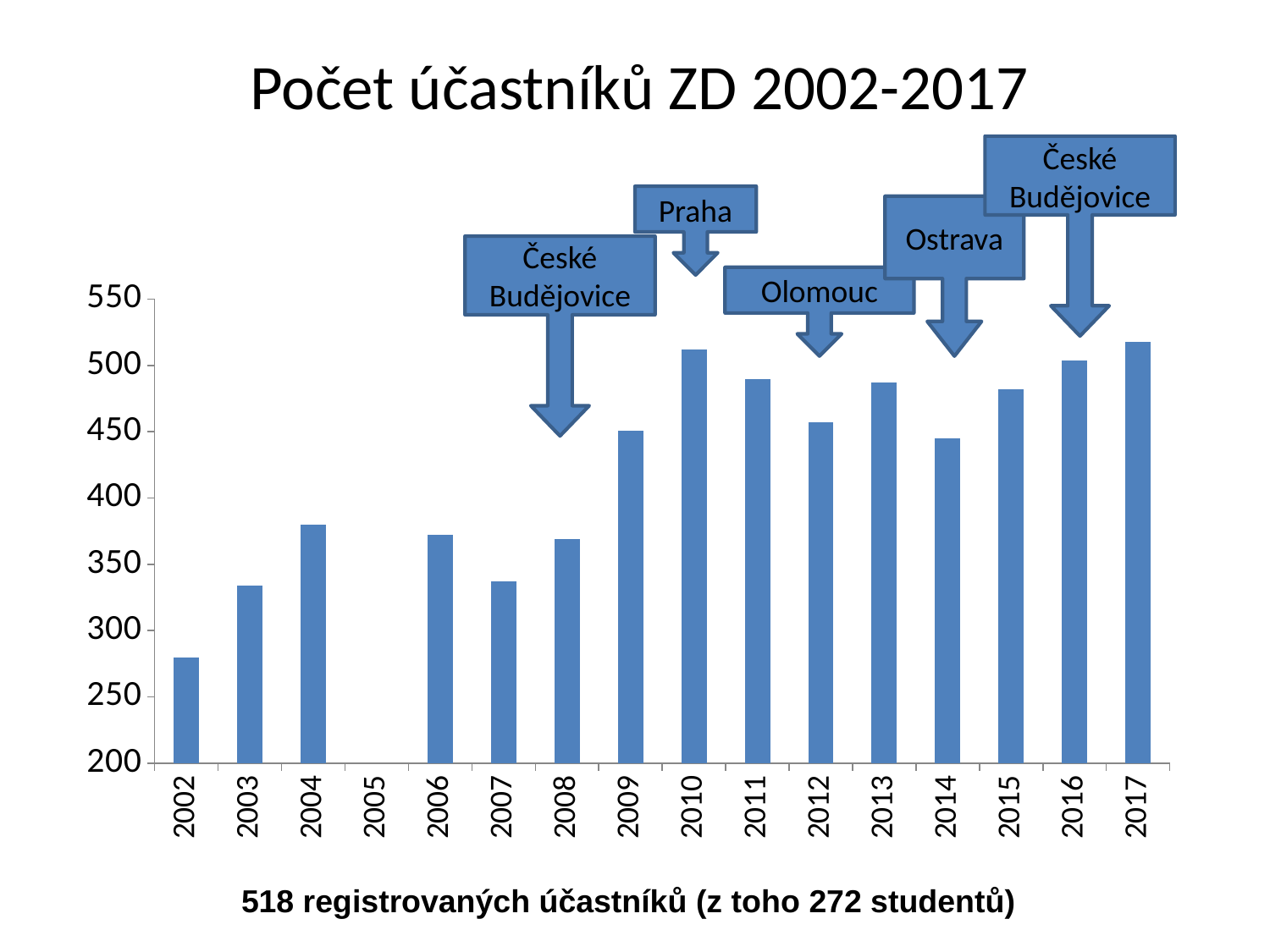
Which year has the higher value, 2003 or 2004? 2004 Is the value for 2004 greater or less than 350? greater Which year on the x axis has no bar plotted? 2005 What is the title of the chart? Počet účastníků ZD 2002-2017 What kind of chart is shown on the slide? bar chart Overall, do the values rise or fall from 2002 to 2017? rise Is the value for 2010 greater or less than 500? greater Which year has the higher value, 2012 or 2013? 2013 How many years are labeled on the x axis of the chart? 16 Is the value for 2002 greater or less than 300? less Which year has the lowest bar in the chart? 2002